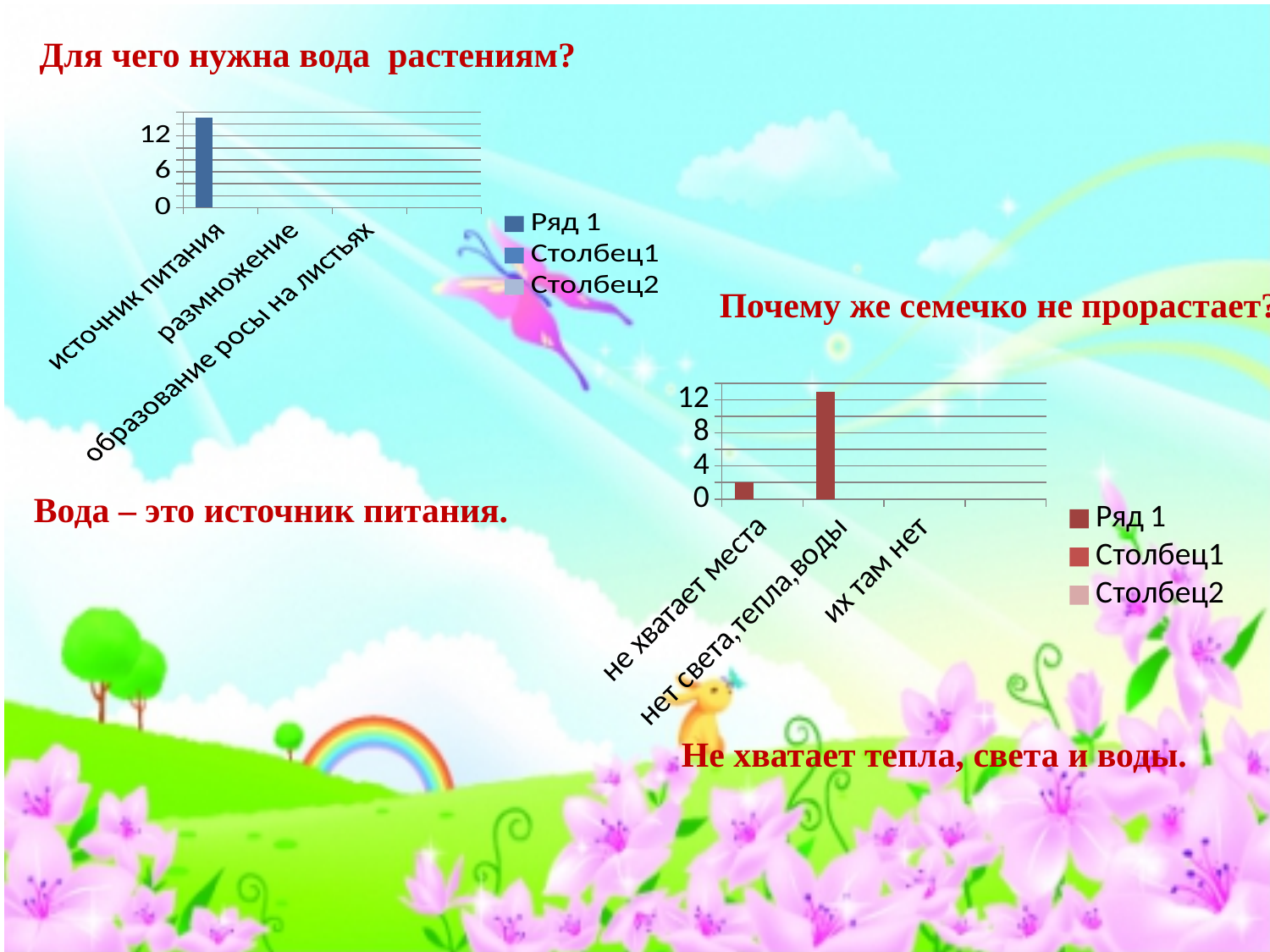
What is the first legend entry of the chart under "Почему же семечко не прорастает?"? Ряд 1 How many entries does the legend of the chart under "Для чего нужна вода растениям?" list? 3 In the chart under "Почему же семечко не прорастает?", is the value for "не хватает места" greater or less than 4? less In the chart under "Почему же семечко не прорастает?", which category has the highest bar? нет света,тепла,воды What kind of chart is the chart under the title "Почему же семечко не прорастает?"? bar chart What kind of chart is the chart under the title "Для чего нужна вода растениям?"? bar chart In the chart under "Для чего нужна вода растениям?", is the value for "источник питания" greater or less than 12? greater How many categories are shown on the x axis of the chart under "Для чего нужна вода растениям?"? 3 In the chart under "Почему же семечко не прорастает?", which is larger: the value for "не хватает места" or for "нет света,тепла,воды"? нет света,тепла,воды In the chart under "Для чего нужна вода растениям?", which category has the highest bar? источник питания How many categories are shown on the x axis of the chart under "Почему же семечко не прорастает?"? 3 In the chart under "Почему же семечко не прорастает?", is the value for "нет света,тепла,воды" greater or less than 8? greater